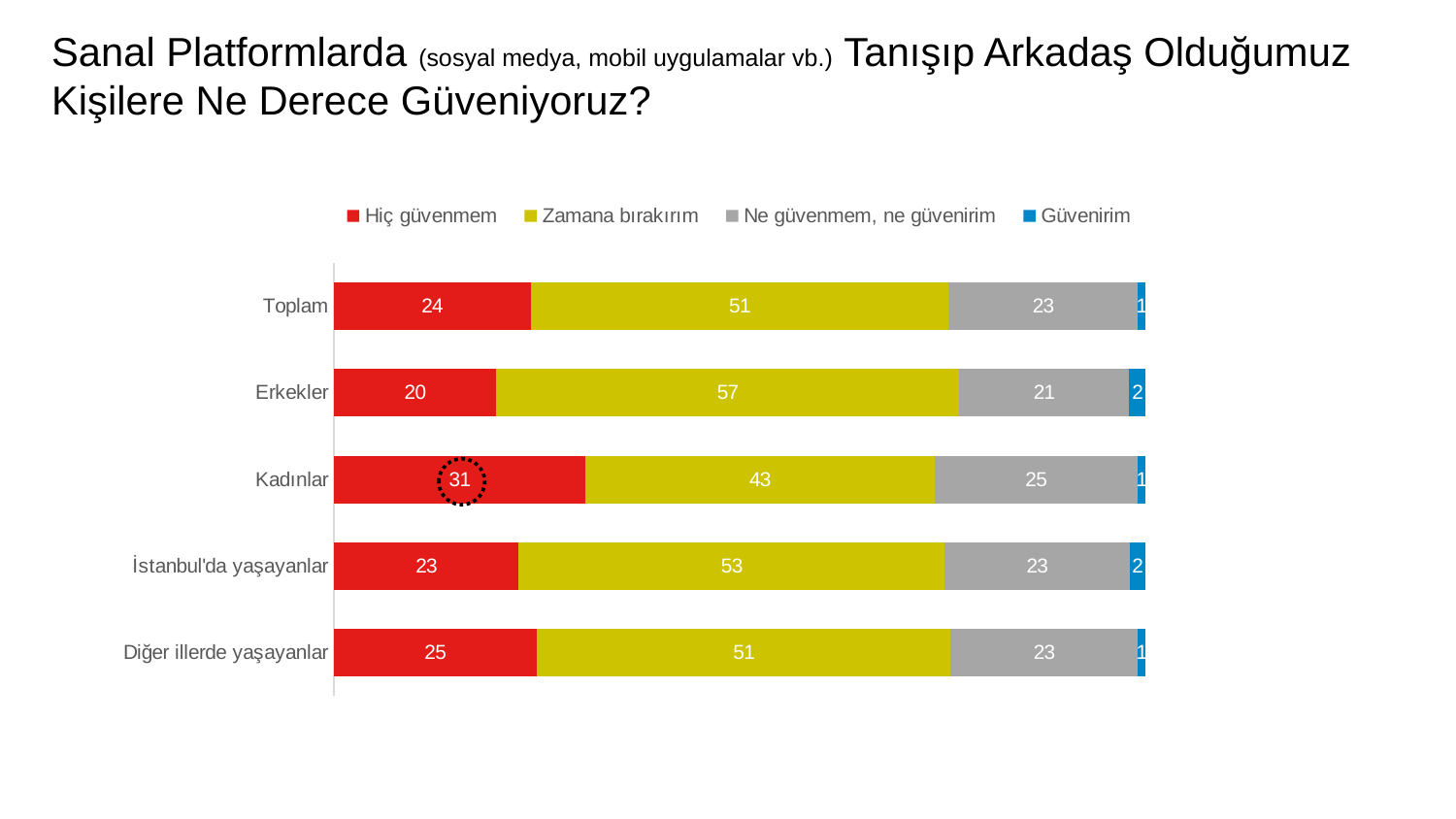
Which category has the lowest "Zamana bırakırım" value? Kadınlar What is the "Güvenirim" value for Toplam? 1 What is the total of the stacked bar for Erkekler? 100 What kind of chart is shown on the slide? Stacked bar chart What is the difference between the "Zamana bırakırım" values for Erkekler and Kadınlar? 14 What is the "Hiç güvenmem" value for Kadınlar? 31 Which is larger: the "Hiç güvenmem" value for Erkekler or for Diğer illerde yaşayanlar? Diğer illerde yaşayanlar How many series does the legend list? 4 How many categories are shown on the chart? 5 What is the "Zamana bırakırım" value for Erkekler? 57 What is the "Ne güvenmem, ne güvenirim" value for İstanbul'da yaşayanlar? 23 Which category has the highest "Hiç güvenmem" value? Kadınlar